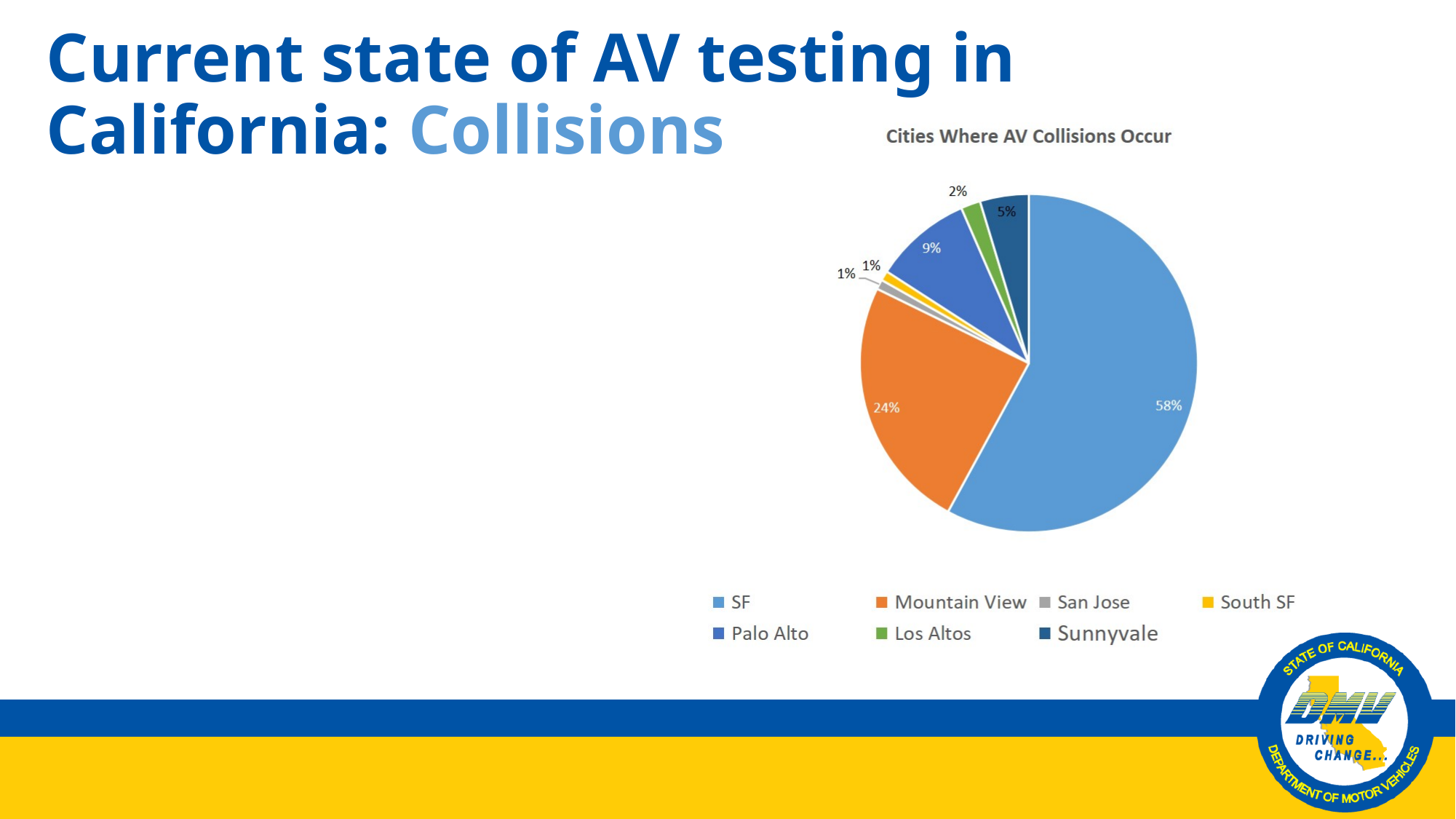
What type of chart is shown on the slide? pie chart What share of AV collisions occur in Sunnyvale? 5% What share of AV collisions occur in Los Altos? 2% What share of AV collisions occur in Mountain View? 24% What is the title of the chart? Cities Where AV Collisions Occur What colour is the slice representing Mountain View? orange How many cities are listed in the chart legend? 7 What share of AV collisions occur in Palo Alto? 9% Which city has the largest share of AV collisions? SF What share of AV collisions occur in SF? 58% What is the difference in percentage points between the SF and Mountain View shares? 34 Which has a larger share of AV collisions, Palo Alto or Sunnyvale? Palo Alto